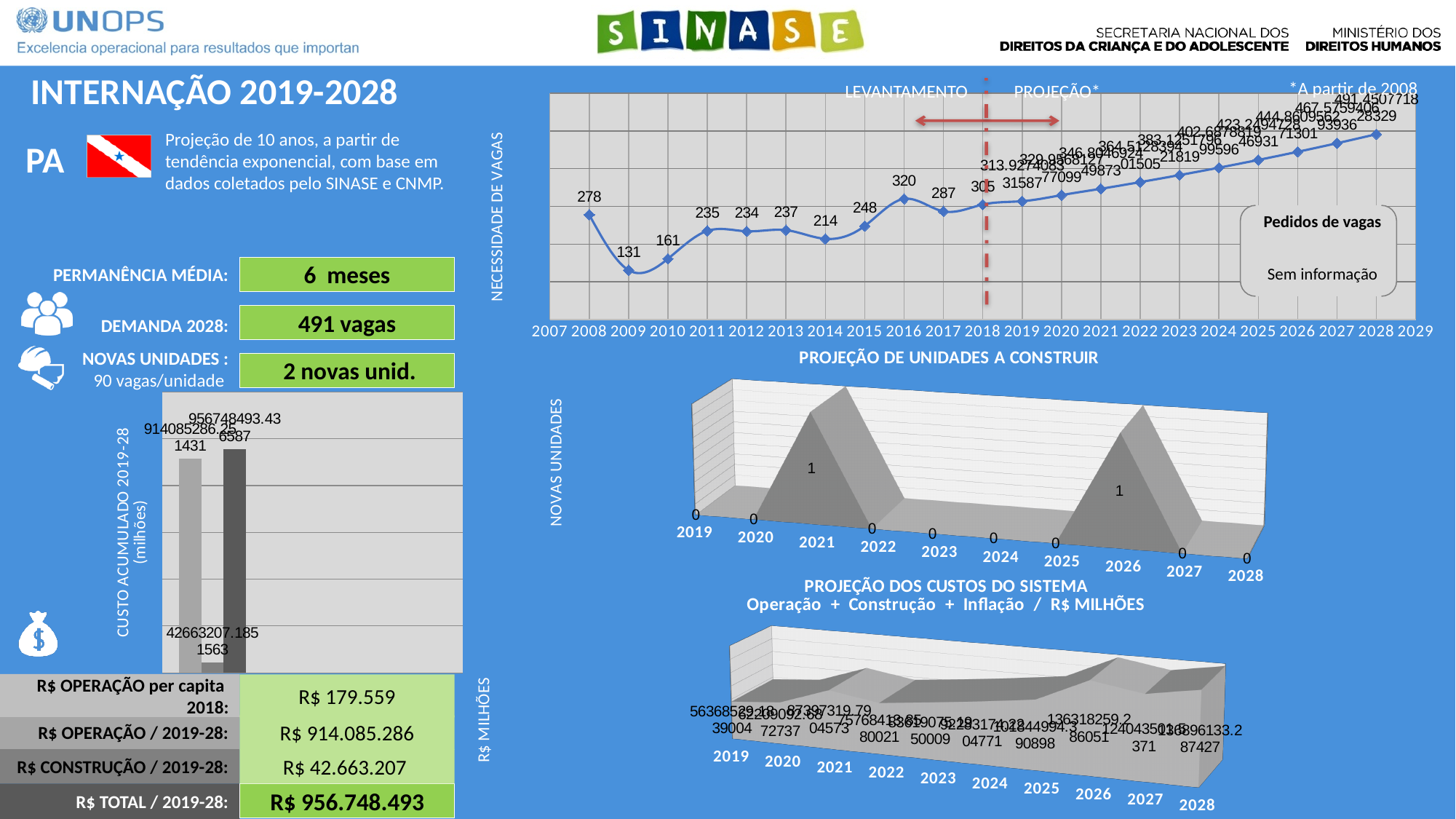
In the NECESSIDADE DE VAGAS line chart, what is the value for 2016? 320 In the NECESSIDADE DE VAGAS line chart, which year has the lowest value? 2009 In the NECESSIDADE DE VAGAS line chart, what is the value for 2018? 305 How many years are shown on the x axis of the PROJEÇÃO DE UNIDADES A CONSTRUIR chart? 10 In the NECESSIDADE DE VAGAS line chart, what is the difference between the values for 2016 and 2017? 33 In the NECESSIDADE DE VAGAS line chart, which year has the larger value, 2014 or 2015? 2015 In the PROJEÇÃO DE UNIDADES A CONSTRUIR chart, what is the value for 2024? 0 What is the y-axis label of the PROJEÇÃO DE UNIDADES A CONSTRUIR chart? NOVAS UNIDADES In the PROJEÇÃO DE UNIDADES A CONSTRUIR chart, what is the value for 2021? 1 In the NECESSIDADE DE VAGAS line chart, do the values rise or fall from 2018 to 2028? rise In the NECESSIDADE DE VAGAS line chart, what is the value for 2008? 278 What kind of chart is the NECESSIDADE DE VAGAS chart at the top right? line chart